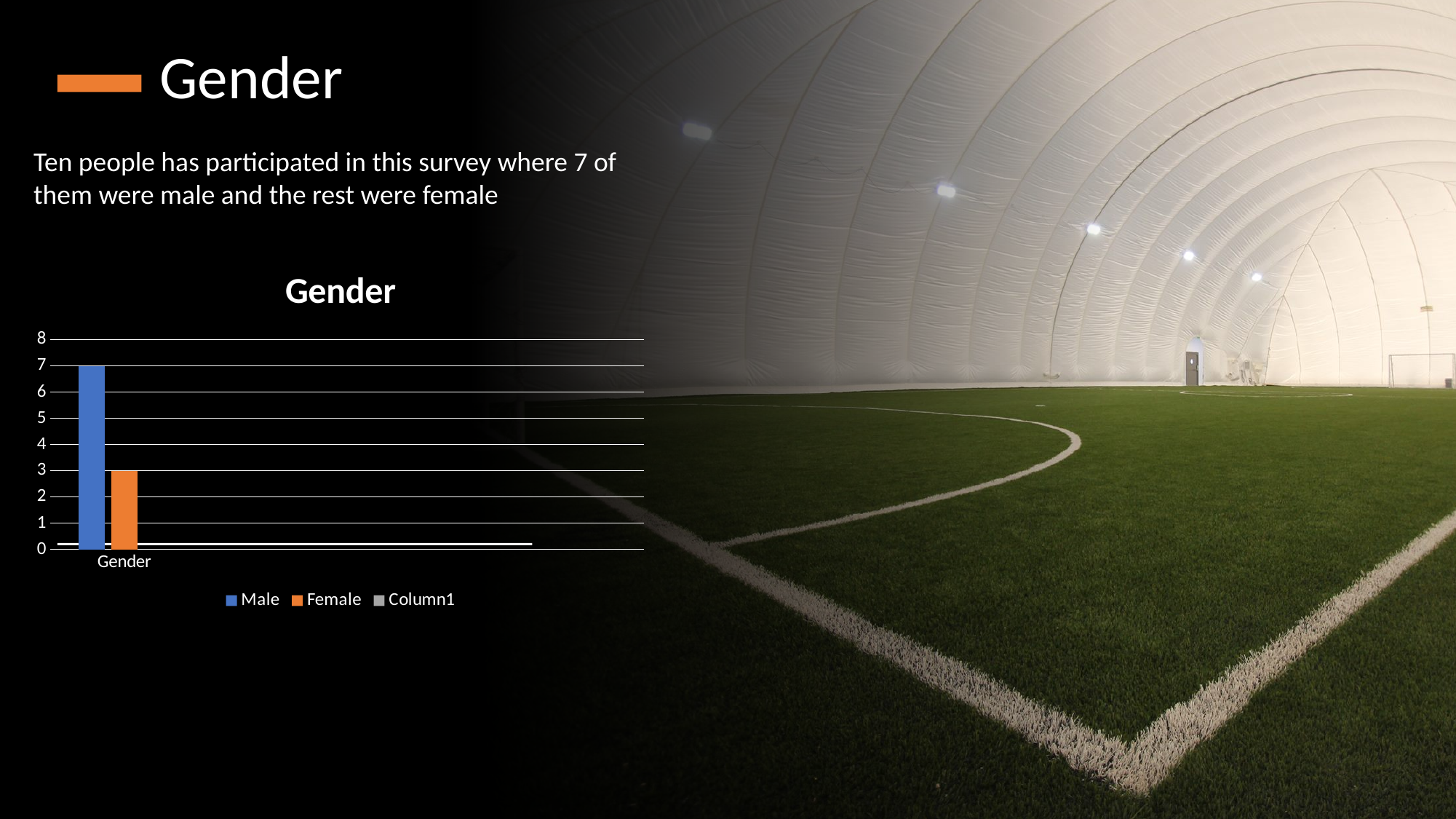
How many categories are shown on the x axis of the Gender chart? 1 How many series does the legend of the Gender chart list? 3 What colour is the Female series in the Gender chart? Orange Is the value for Female in the Gender chart greater or less than 4? less What kind of chart is shown on the slide? Bar chart Is the value for Male in the Gender chart greater or less than 5? greater What is the difference between the Male and Female values in the Gender chart? 4 What is the value of the Female bar in the Gender chart? 3 Which series has the taller bar in the Gender chart, Male or Female? Male Which series has the highest value in the Gender chart? Male What is the value of the Male bar in the Gender chart? 7 Which plotted series has the lowest value in the Gender chart? Female